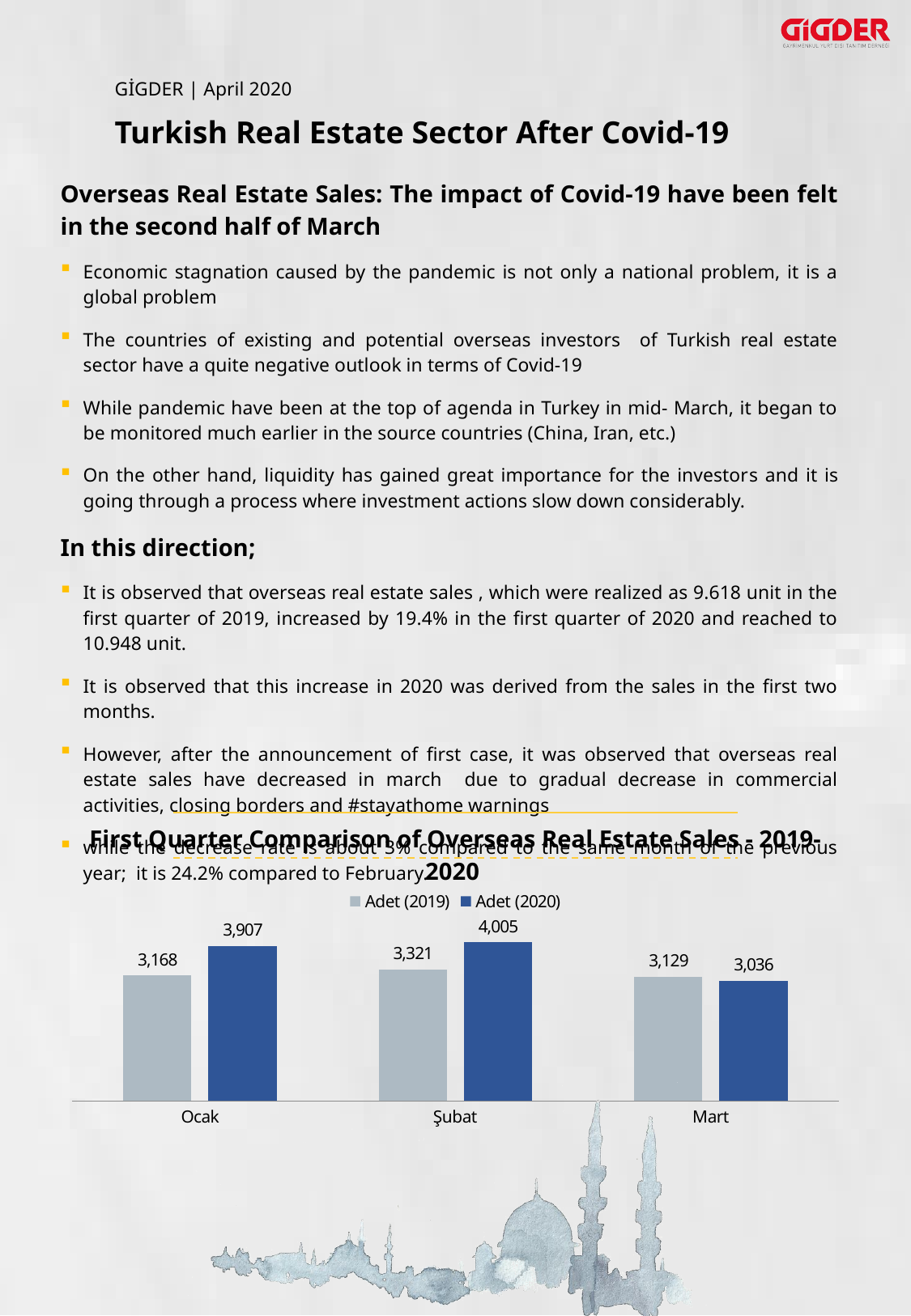
Which month has the lowest Adet (2020) value? Mart What is the value for Adet (2019) in Ocak? 3,168 Which month has the highest Adet (2020) value? Şubat What is the value for Adet (2020) in Mart? 3,036 How many series does the chart legend list? 2 What is the value for Adet (2020) in Şubat? 4,005 How many months are shown on the x axis of the chart? 3 Do the Adet (2020) values rise or fall from Şubat to Mart? Fall What kind of chart is shown on the slide? Bar chart What is the difference between Adet (2020) and Adet (2019) in Ocak? 739 In Mart, which is larger: Adet (2019) or Adet (2020)? Adet (2019) What is the value for Adet (2019) in Mart? 3,129